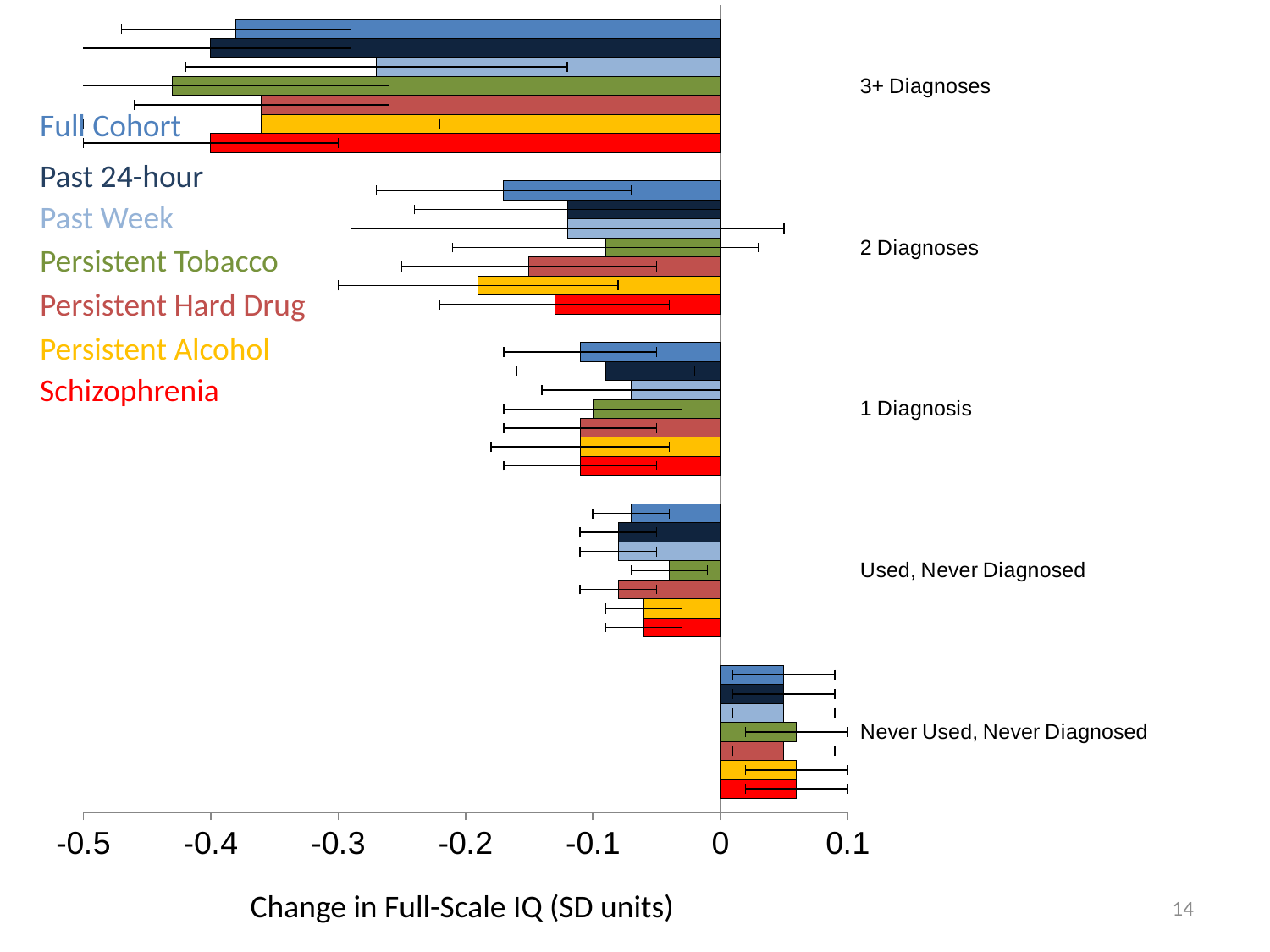
What colour represents the Schizophrenia series? red How many diagnosis categories are shown on the chart? 5 In the 3+ Diagnoses group, which bar extends further from zero: Persistent Tobacco or Past Week? Persistent Tobacco Is the value for Persistent Tobacco in the Used, Never Diagnosed group greater or less than -0.1? greater What is the title of the x axis? Change in Full-Scale IQ (SD units) Going from 3+ Diagnoses down to Never Used, Never Diagnosed, do the Full Cohort values increase or decrease? increase How many series does the legend list? 7 Which diagnosis group has the most negative Full Cohort value? 3+ Diagnoses Is the value for Persistent Tobacco in the Never Used, Never Diagnosed group greater or less than 0? greater Is the value for Persistent Alcohol in the 2 Diagnoses group greater or less than -0.1? less What kind of chart is shown on the slide? bar chart